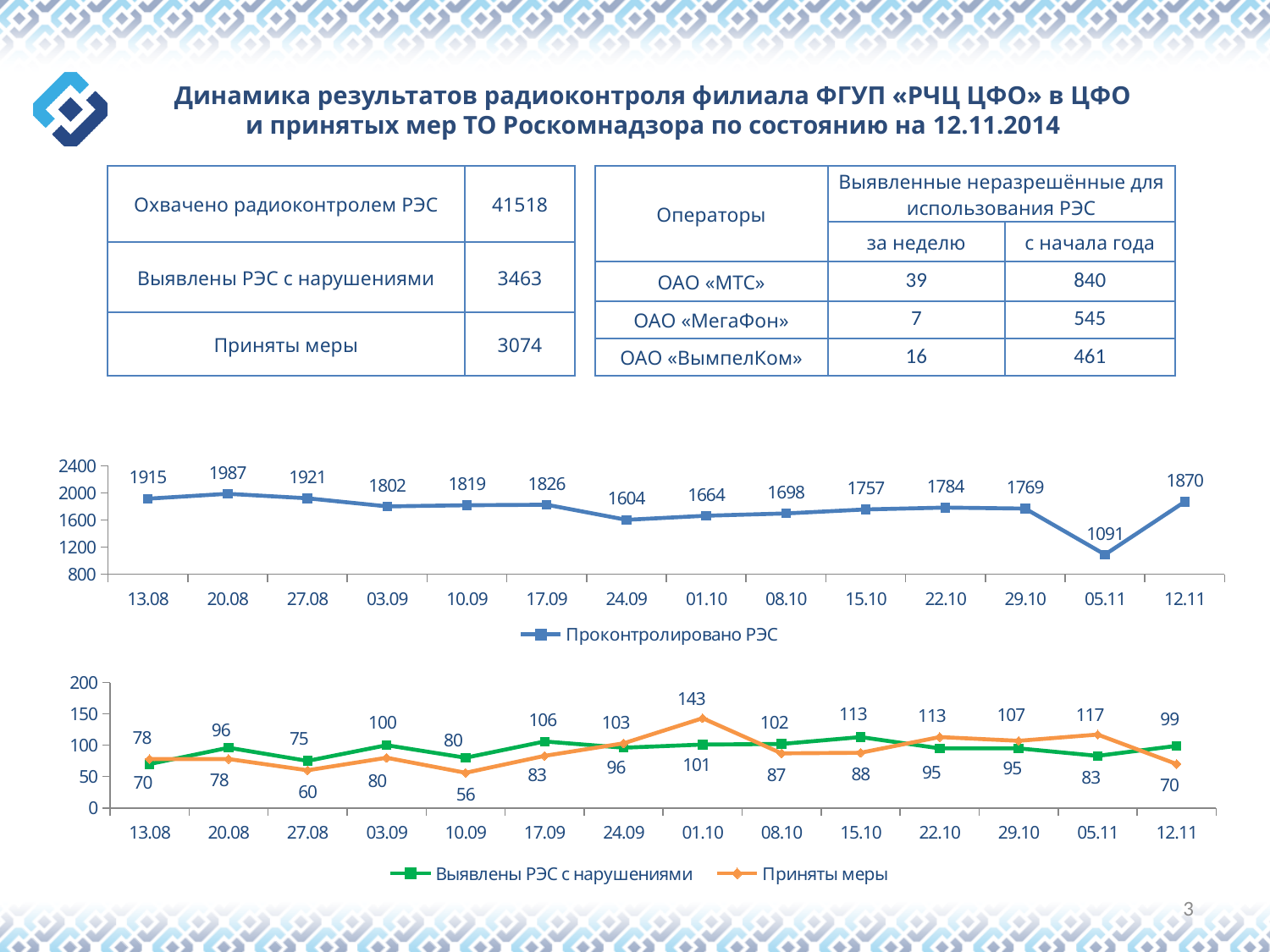
In the bottom chart, what is the value of Выявлены РЭС с нарушениями for 15.10? 113 In the bottom chart, what is the value of Приняты меры for 01.10? 143 In the top chart (Проконтролировано РЭС), what is the value for 05.11? 1091 How many data points are plotted in the top chart (Проконтролировано РЭС)? 14 What type of chart is the top chart (Проконтролировано РЭС)? Line chart How many series does the legend of the bottom chart list? 2 In the top chart (Проконтролировано РЭС), what is the value for 20.08? 1987 In the top chart (Проконтролировано РЭС), which date has the highest value? 20.08 In the bottom chart, which is larger for 12.11: Выявлены РЭС с нарушениями or Приняты меры? Выявлены РЭС с нарушениями In the bottom chart, what is the difference between Выявлены РЭС с нарушениями and Приняты меры for 10.09? 24 In the top chart (Проконтролировано РЭС), what is the difference between the values for 12.11 and 05.11? 779 In the top chart (Проконтролировано РЭС), which date has the lowest value? 05.11